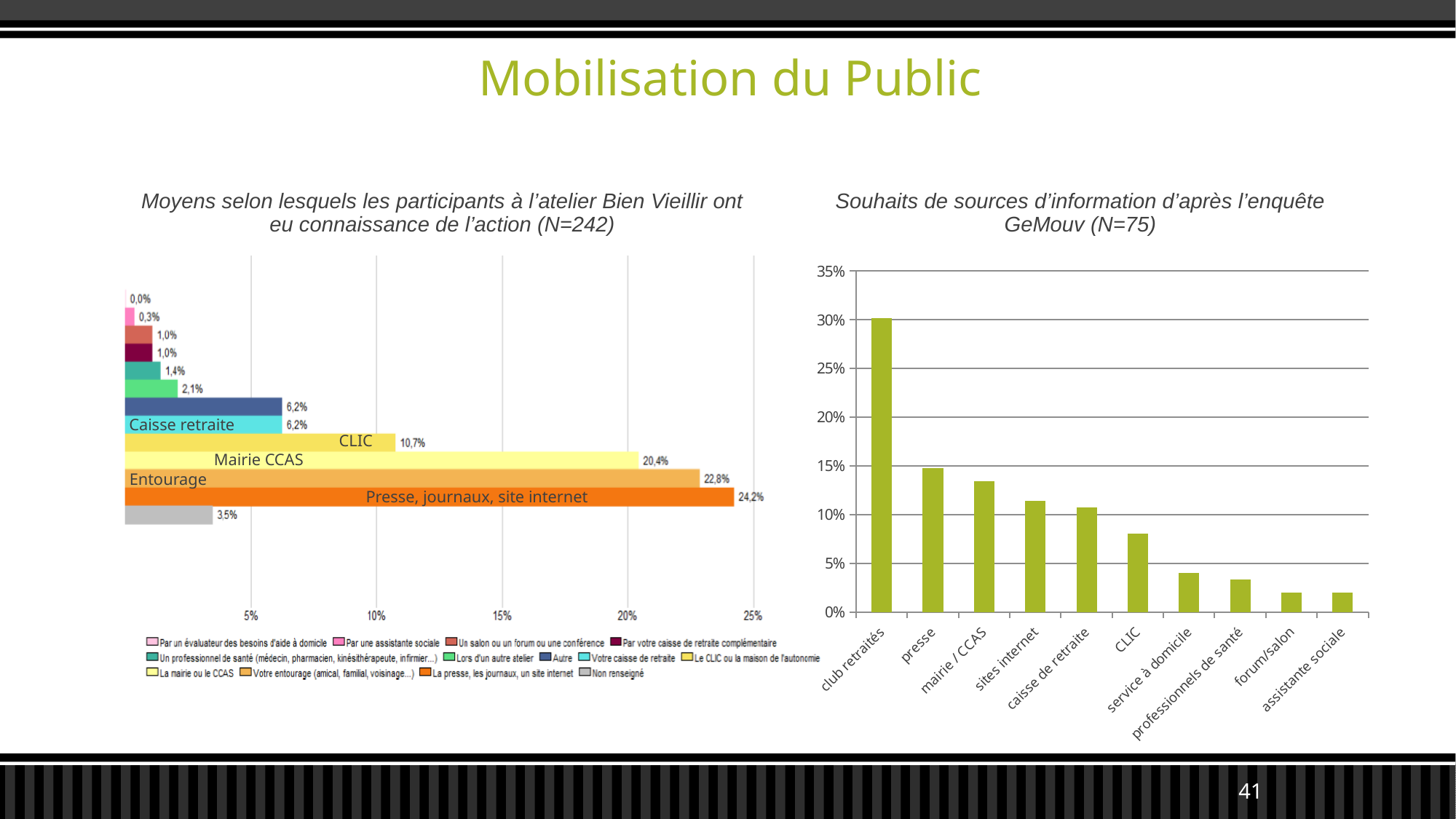
In the left chart (Moyens selon lesquels les participants ... ont eu connaissance de l'action), what is the value for 'Mairie CCAS'? 20,4% In the left chart (Moyens selon lesquels les participants ... ont eu connaissance de l'action), what is the value for 'CLIC'? 10,7% How many categories are shown in the right chart (Souhaits de sources d'information d'après l'enquête GeMouv)? 10 What kind of chart is the right chart (Souhaits de sources d'information d'après l'enquête GeMouv)? bar chart In the left chart (Moyens selon lesquels les participants ... ont eu connaissance de l'action), what is the value for 'Entourage'? 22,8% In the right chart (Souhaits de sources d'information d'après l'enquête GeMouv), do the values rise or fall from left to right along the x axis? fall In the right chart (Souhaits de sources d'information d'après l'enquête GeMouv), is the value for 'club retraités' greater or less than 25%? greater In the left chart (Moyens selon lesquels les participants ... ont eu connaissance de l'action), what is the value for 'Presse, journaux, site internet'? 24,2% In the left chart (Moyens selon lesquels les participants ... ont eu connaissance de l'action), which labelled category has the highest value? Presse, journaux, site internet In the right chart (Souhaits de sources d'information d'après l'enquête GeMouv), is the value for 'CLIC' greater or less than 10%? less In the right chart (Souhaits de sources d'information d'après l'enquête GeMouv), which category has the highest value? club retraités In the left chart (Moyens selon lesquels les participants ... ont eu connaissance de l'action), what is the difference between 'Presse, journaux, site internet' and 'Entourage'? 1,4%